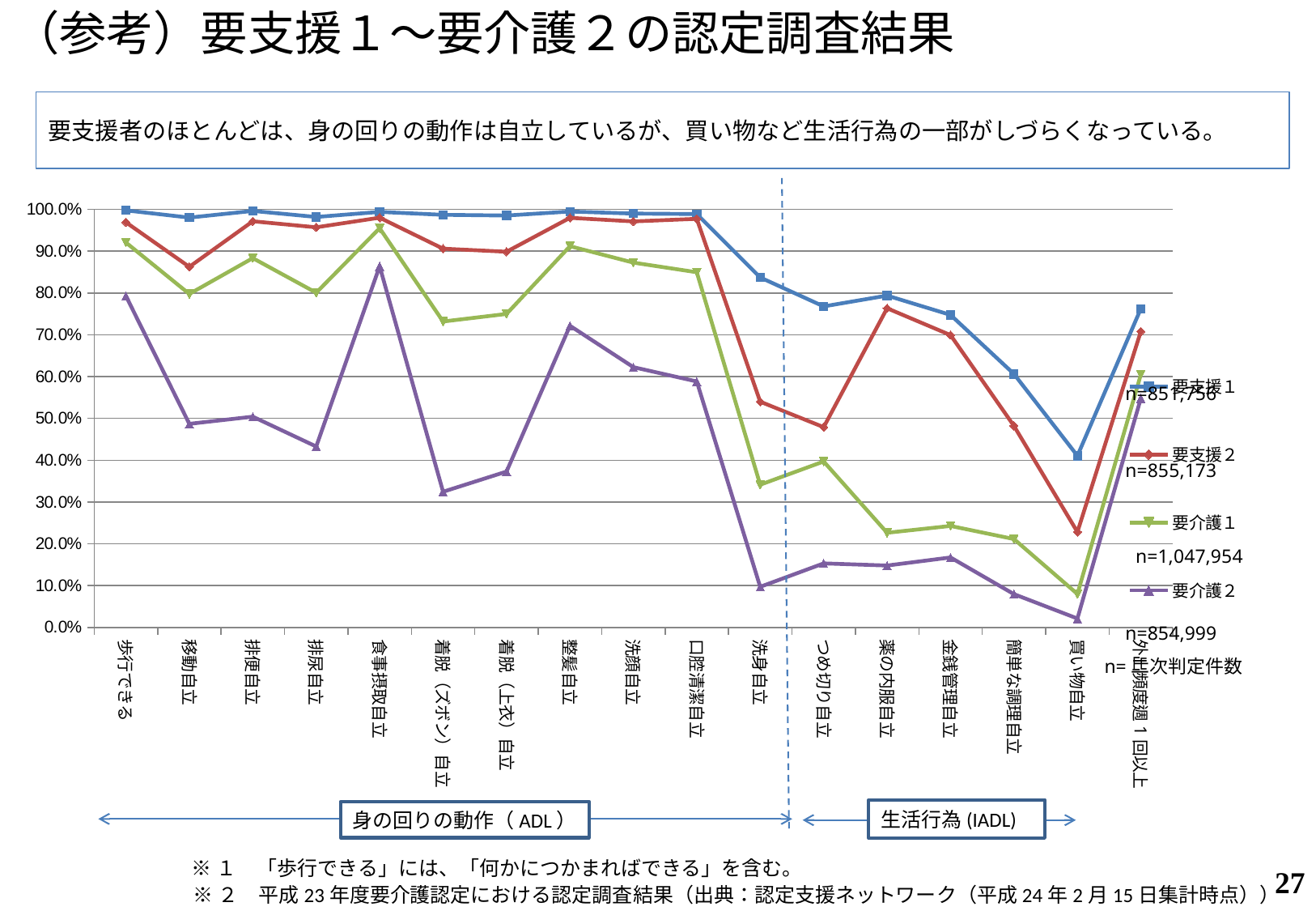
What kind of chart is shown on the slide? line chart Is the value for 要介護１ at 洗身自立 greater or less than 40.0%? less How many categories are plotted along the x axis of the chart? 17 For the 要介護２ series, which category has the lowest value? 買い物自立 What n value is shown next to the legend entry for 要介護１? n=1,047,954 For the 要支援１ series, do the values rise or fall from 金銭管理自立 to 買い物自立? fall For the 要介護２ series, which category has the highest value? 食事摂取自立 At 歩行できる, which series has the larger value, 要支援１ or 要介護２? 要支援１ How many series does the chart's legend list? 4 At 買い物自立, which series has the larger value, 要支援１ or 要支援２? 要支援１ Is the value for 要支援１ at 買い物自立 greater or less than 50.0%? less Is the value for 要介護２ at 買い物自立 greater or less than 10.0%? less